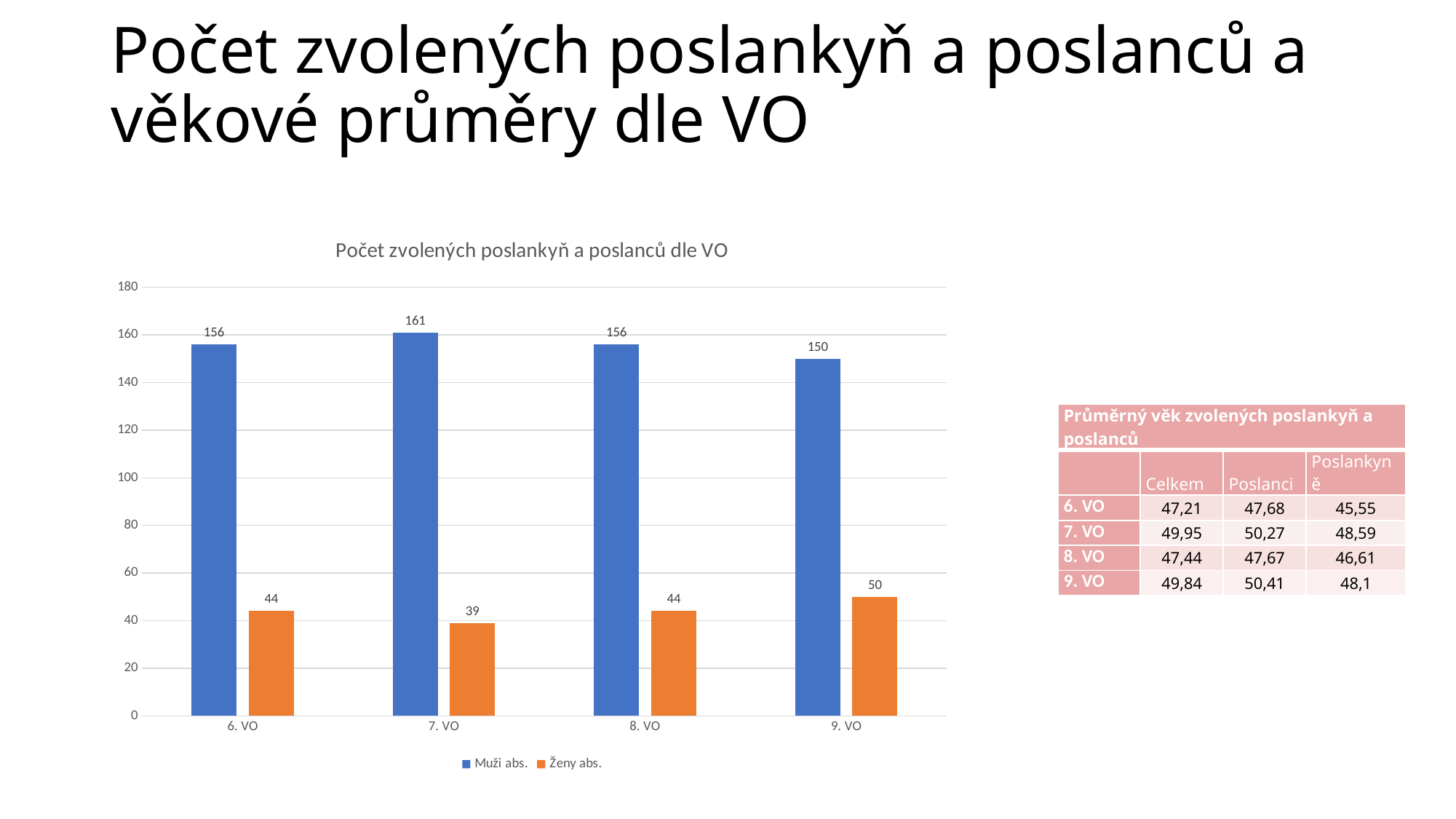
What is the value for Ženy abs. in 9. VO? 50 Which category has the highest value for Muži abs.? 7. VO Which category has the lowest value for Ženy abs.? 7. VO Which is larger: Ženy abs. in 8. VO or Ženy abs. in 9. VO? Ženy abs. in 9. VO How many series does the legend list? 2 How many categories are shown on the x axis? 4 What kind of chart is shown? bar chart What is the difference between Muži abs. and Ženy abs. in 6. VO? 112 What is the value for Ženy abs. in 7. VO? 39 What is the title of the chart? Počet zvolených poslankyň a poslanců dle VO Which category has the lowest value for Muži abs.? 9. VO What is the value for Muži abs. in 7. VO? 161